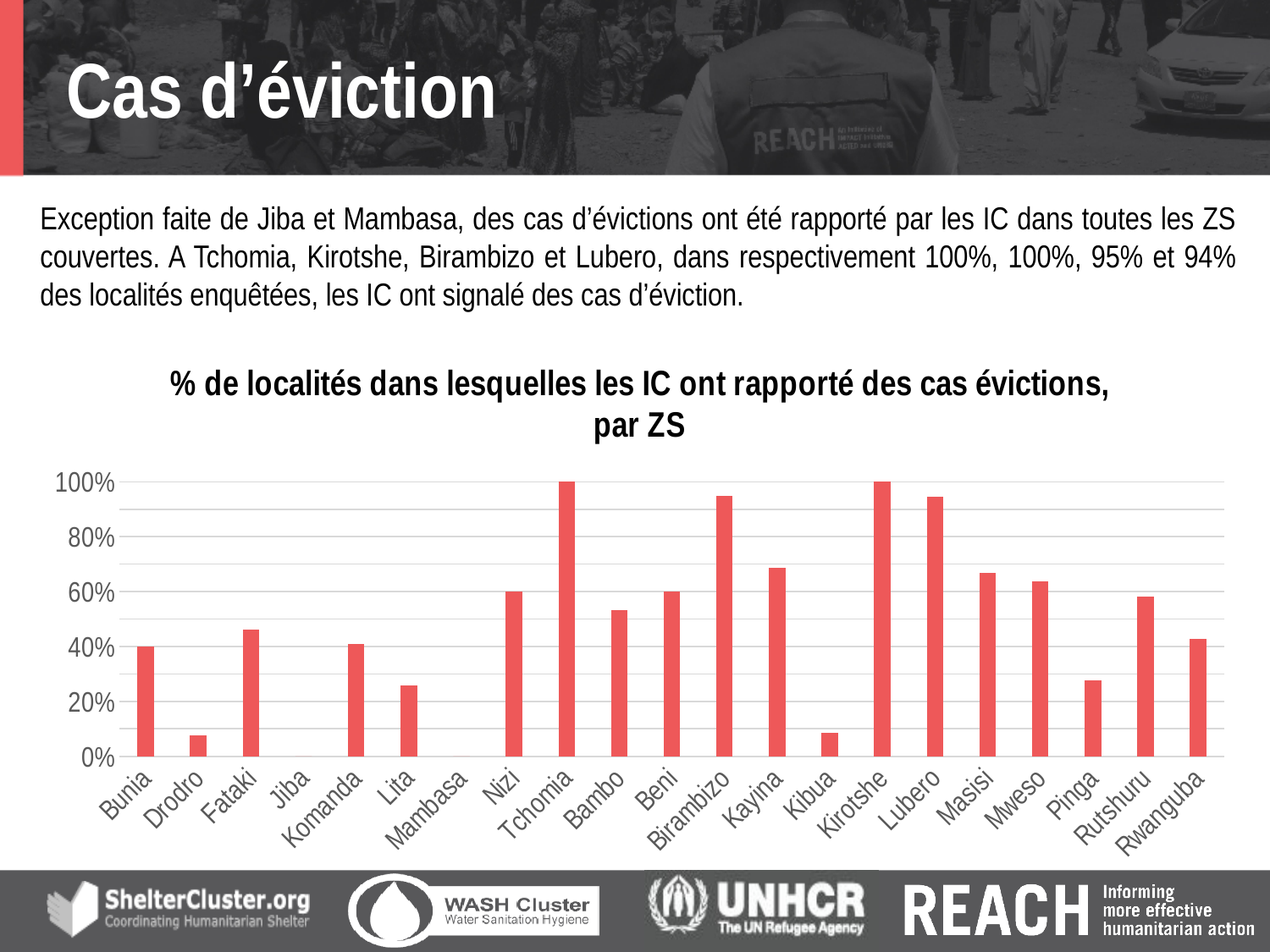
Is the value for Kayina greater or less than 60%? greater Is the value for Pinga greater or less than 40%? less Which two ZS have the highest value in the chart? Tchomia and Kirotshe What is the value for Tchomia? 100% What kind of chart is shown on the slide? bar chart What is the difference between the values for Tchomia and Lubero? 6% Which has the larger value, Kayina or Bambo? Kayina What is the title of the chart? % de localités dans lesquelles les IC ont rapporté des cas évictions, par ZS Is the value for Drodro greater or less than 20%? less How many ZS (categories) are shown on the x axis of the chart? 21 Which two ZS have the lowest value in the chart? Jiba and Mambasa What is the value for Jiba? 0%